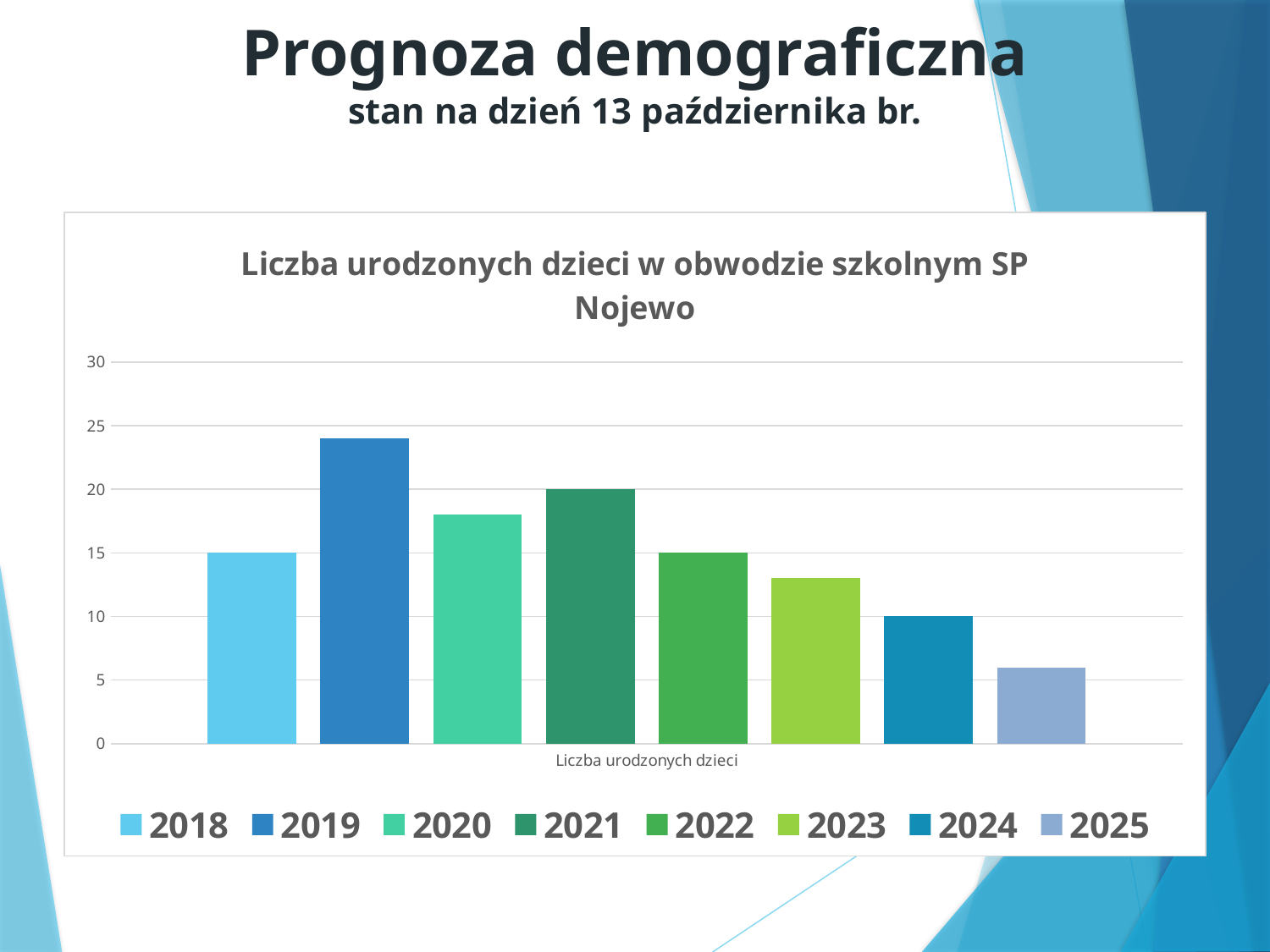
What is the value for 2021? 20 Which year has the lowest number of children born? 2025 What type of chart is shown on the slide? bar chart Is the value for 2023 greater or less than 15? less Do the values rise or fall from 2021 to 2025? fall What is the value for 2024? 10 What is the value for 2018? 15 What is the difference between the values for 2021 and 2024? 10 Which is larger, the value for 2019 or the value for 2020? 2019 Which year has the highest number of children born? 2019 How many series does the legend list? 8 Is the value for 2019 greater or less than 20? greater